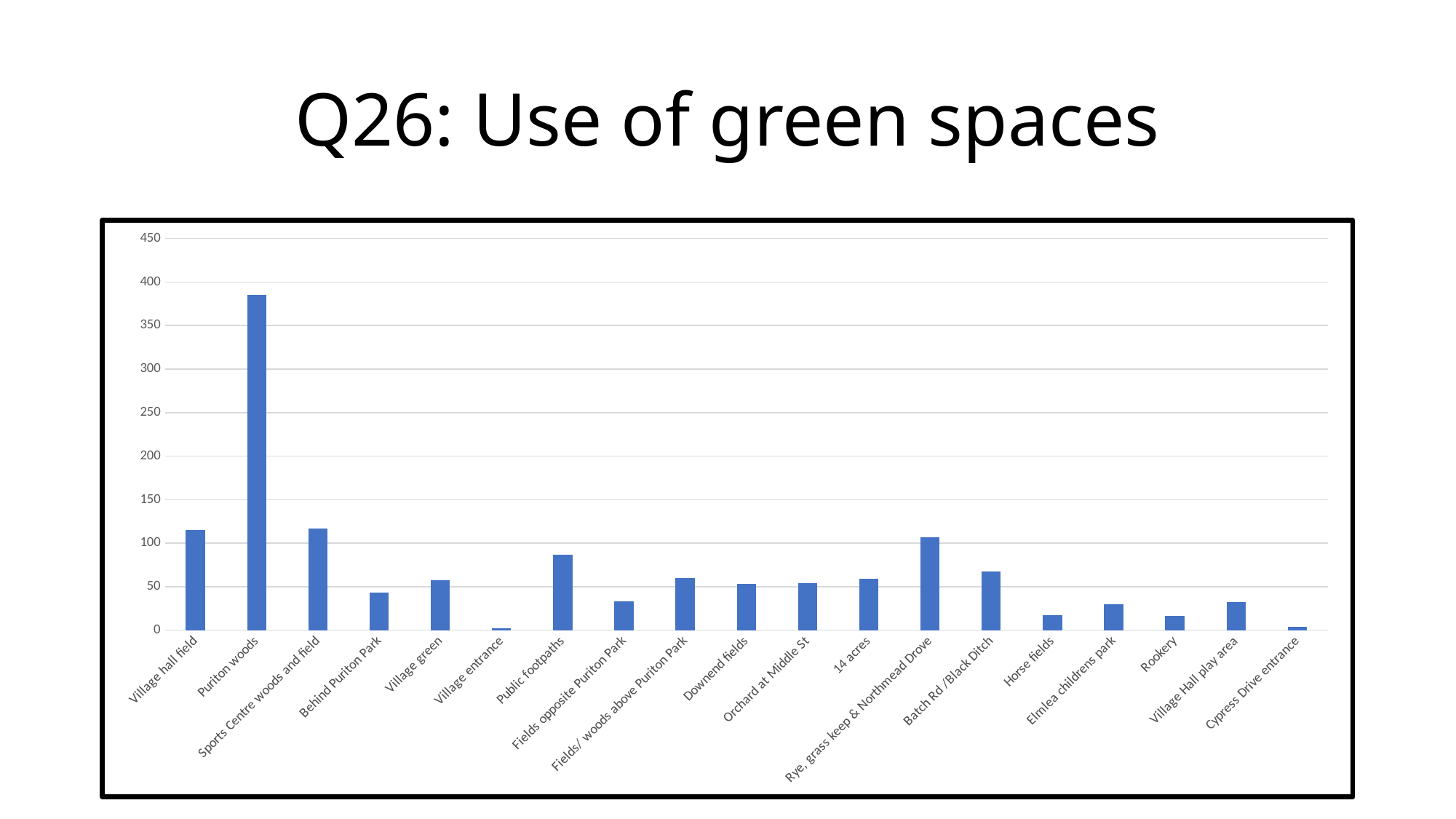
Is the value for Behind Puriton Park greater or less than 50? less Is the value for Puriton woods greater or less than 350? greater Is the value for Public footpaths greater or less than 50? greater Which has the larger value, Rye, grass keep & Northmead Drove or Batch Rd /Black Ditch? Rye, grass keep & Northmead Drove How many green spaces (categories) are plotted in the chart? 19 What is the title of the slide? Q26: Use of green spaces What kind of chart is shown on the slide? bar chart Which green space has the highest value in the chart? Puriton woods Which has the larger value, Public footpaths or Fields opposite Puriton Park? Public footpaths